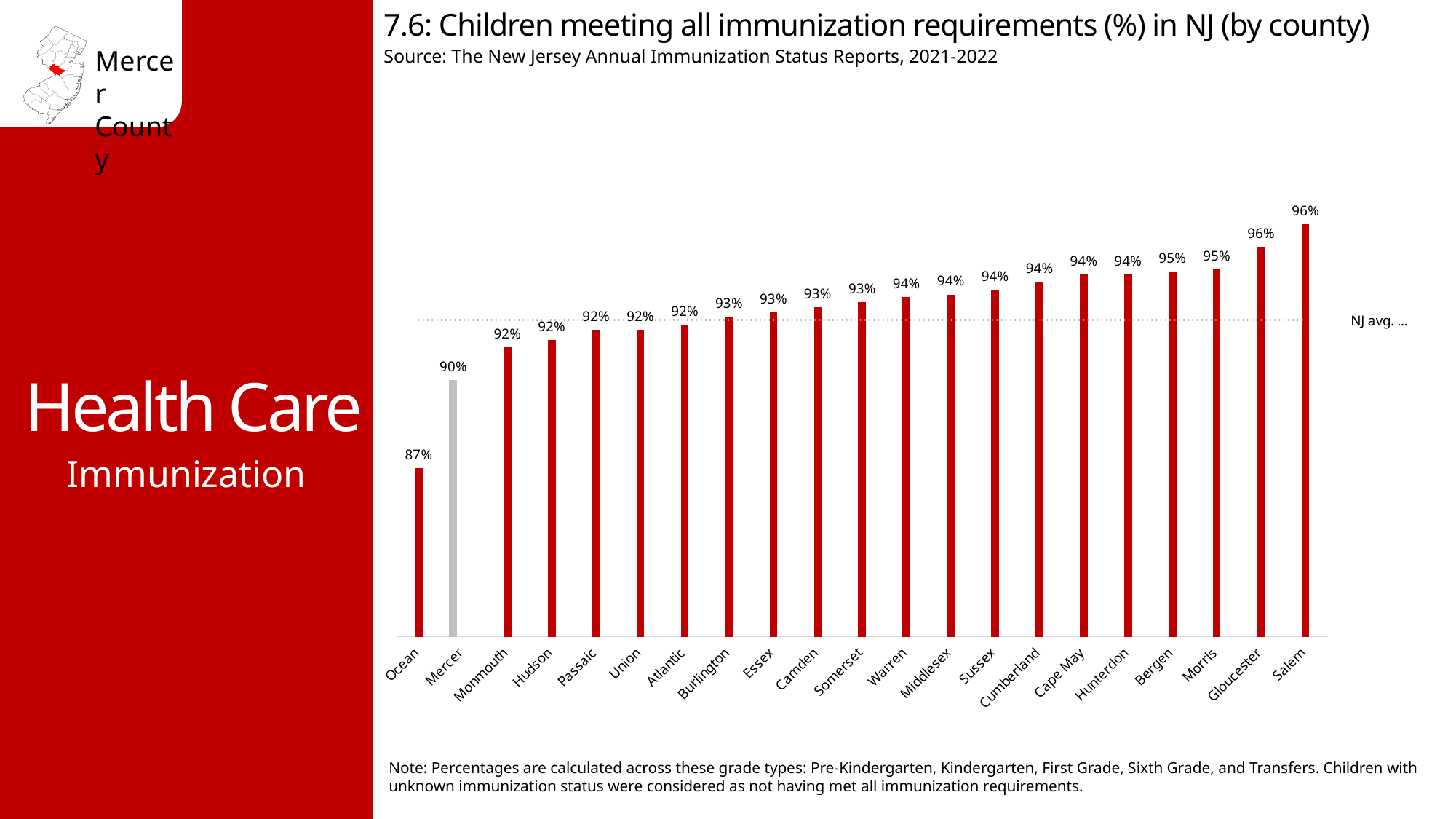
What is the difference in percentage points between Salem and Ocean? 9 percentage points How many counties are shown in the chart? 21 What percentage of children in Mercer County met all immunization requirements? 90% Which has a higher value, Mercer or Monmouth? Monmouth What percentage is shown for Salem County? 96% What is the value shown for Bergen County? 95% How many percentage points higher is Mercer than Ocean? 3 percentage points What is the value shown for Ocean County? 87% What type of chart is used on this slide? Bar chart Do the values generally rise or fall moving from left to right across the counties? Rise Which county has the lowest percentage of children meeting all immunization requirements? Ocean Which county has the tallest bar in the chart? Salem